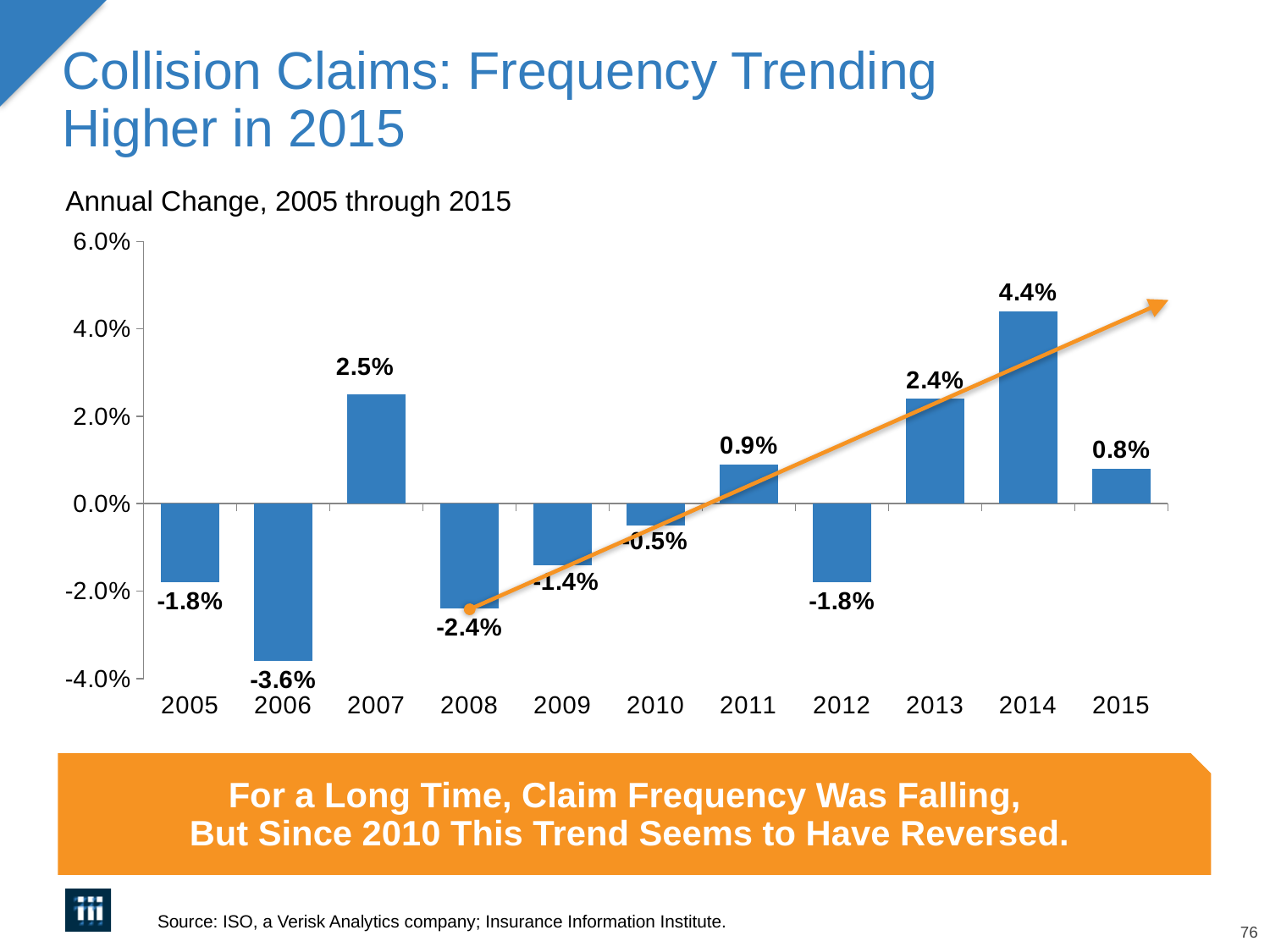
Which year has the larger annual change, 2007 or 2011? 2007 What is the annual change in collision claim frequency for 2014? 4.4% Which year has the lowest annual change? 2006 What is the subtitle printed above the chart? Annual Change, 2005 through 2015 What is the annual change shown for 2010? -0.5% Do the annual change values generally rise or fall from 2010 to 2014? Rise What is the difference between the annual change in 2014 and in 2013? 2.0% How many years are plotted on the chart? 11 Which year has the highest annual change? 2014 What kind of chart is shown on the slide? Bar chart Which two years share the same annual change value of -1.8%? 2005 and 2012 What is the annual change shown for 2006? -3.6%